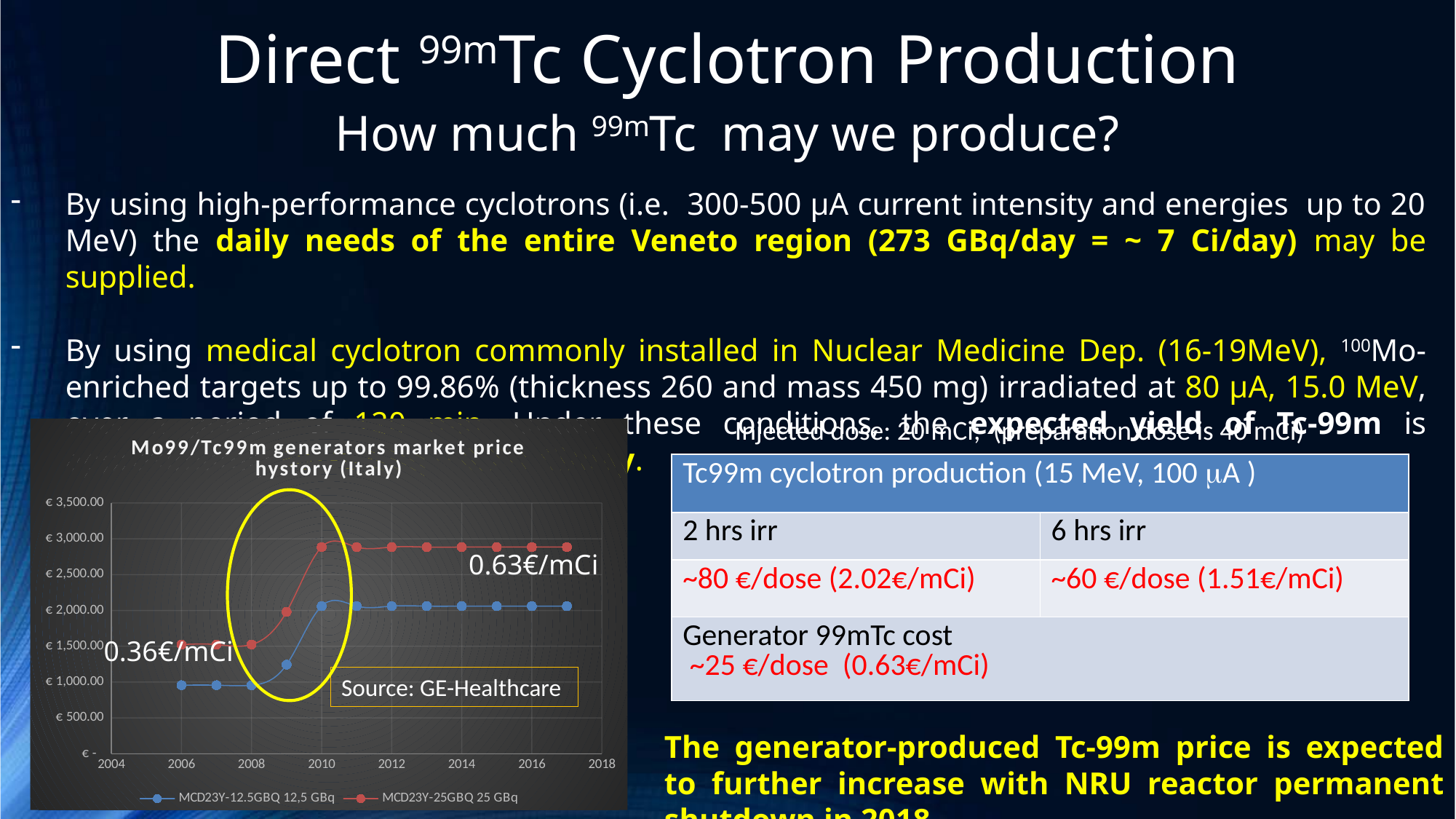
Is the value of the MCD23Y-25GBQ 25 GBq series in 2008 greater or less than € 2,000.00? less What source is cited in the box inside the chart? GE-Healthcare Does the MCD23Y-12.5GBQ 12,5 GBq series rise or fall between 2008 and 2010? rise Is the value of the MCD23Y-25GBQ 25 GBq series in 2010 greater or less than € 2,500.00? greater Is the value of the MCD23Y-12.5GBQ 12,5 GBq series in 2012 greater or less than € 1,500.00? greater How many data points are plotted for the MCD23Y-25GBQ 25 GBq series? 12 What is the title of the chart? Mo99/Tc99m generators market price hystory (Italy) In 2014, which series has the higher value, MCD23Y-25GBQ 25 GBq or MCD23Y-12.5GBQ 12,5 GBq? MCD23Y-25GBQ 25 GBq How many series does the chart's legend list? 2 Which series is plotted in red? MCD23Y-25GBQ 25 GBq What kind of chart is shown on the slide? line chart